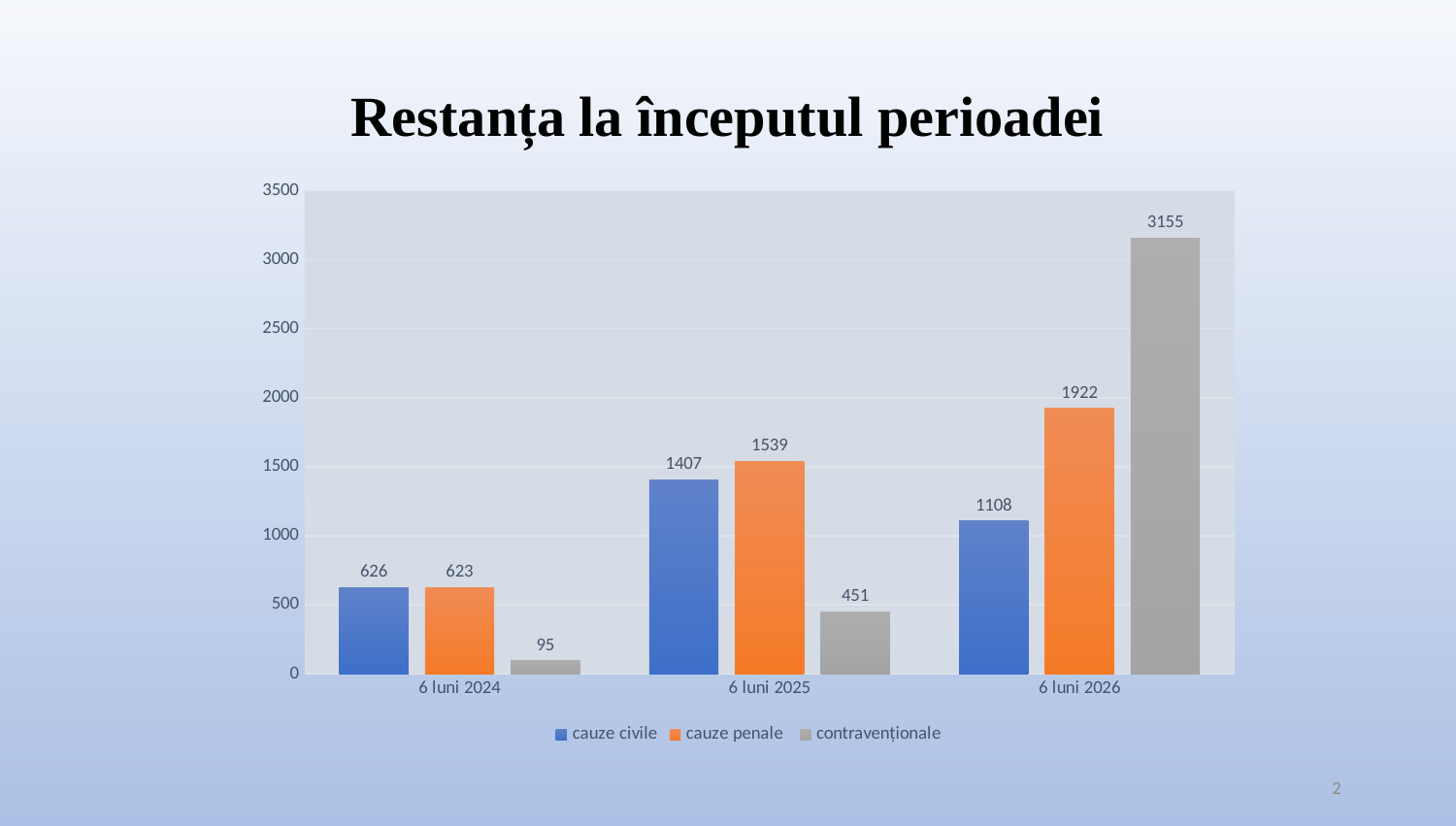
How many series does the legend list? 3 What is the value for cauze civile in 6 luni 2025? 1407 Is the value for cauze penale in 6 luni 2025 greater or less than 1500? greater What is the value for cauze penale in 6 luni 2026? 1922 What is the value for contravenționale in 6 luni 2024? 95 How many categories are shown on the x axis? 3 Which is larger: cauze civile in 6 luni 2026 or cauze penale in 6 luni 2026? cauze penale in 6 luni 2026 What is the difference between contravenționale in 6 luni 2026 and in 6 luni 2025? 2704 Which category has the highest value for contravenționale? 6 luni 2026 What is the title of the chart? Restanța la începutul perioadei What kind of chart is shown on the slide? bar chart Which category has the lowest value for cauze civile? 6 luni 2024